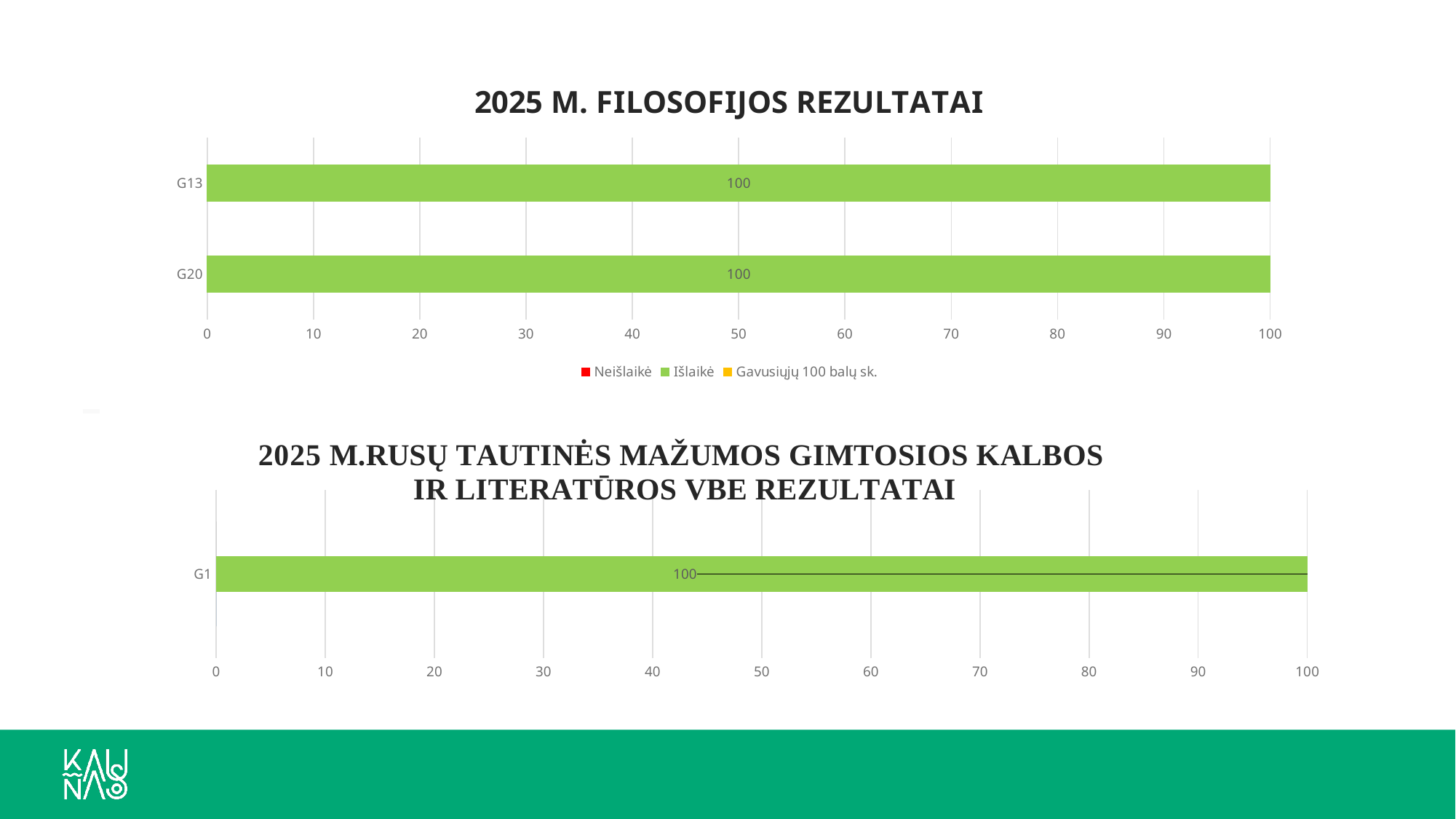
What kind of chart is the top chart titled '2025 M. FILOSOFIJOS REZULTATAI'? Bar chart In the chart titled '2025 M. FILOSOFIJOS REZULTATAI', what is the difference between the values for G13 and G20? 0 What kind of chart is the bottom chart about Rusų tautinės mažumos gimtosios kalbos ir literatūros VBE rezultatai? Bar chart In the bottom chart about Rusų tautinės mažumos gimtosios kalbos ir literatūros VBE rezultatai, what is the value shown for G1? 100 In the bottom chart about Rusų tautinės mažumos gimtosios kalbos ir literatūros VBE rezultatai, how many categories are shown? 1 In the chart titled '2025 M. FILOSOFIJOS REZULTATAI', how many series does the legend list? 3 In the chart titled '2025 M. FILOSOFIJOS REZULTATAI', what is the highest value shown on the horizontal axis? 100 In the chart titled '2025 M. FILOSOFIJOS REZULTATAI', which legend entry is shown in green? Išlaikė In the chart titled '2025 M. FILOSOFIJOS REZULTATAI', how many categories are shown on the vertical axis? 2 In the chart titled '2025 M. FILOSOFIJOS REZULTATAI', is the value for G13 greater or less than 50? greater In the chart titled '2025 M. FILOSOFIJOS REZULTATAI', what is the value shown for G20? 100 In the chart titled '2025 M. FILOSOFIJOS REZULTATAI', what is the value shown for G13? 100